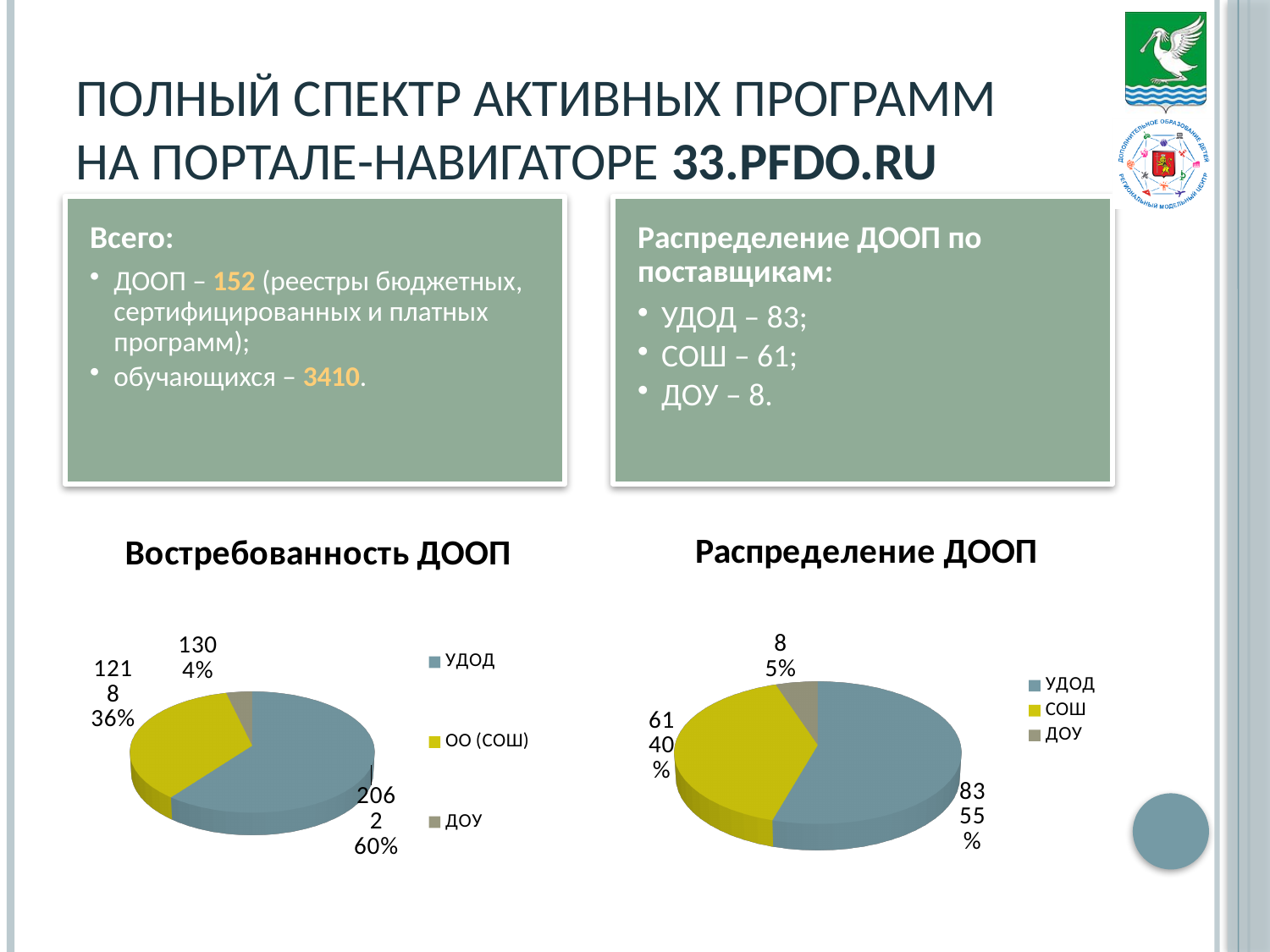
In the 'Востребованность ДООП' chart, which is larger, the slice for ОО (СОШ) or the slice for ДОУ? ОО (СОШ) In the 'Распределение ДООП' chart, which category has the smallest slice? ДОУ In the 'Востребованность ДООП' chart, what share of the pie does ДОУ have? 4% What kind of chart is the 'Распределение ДООП' chart? pie chart In the 'Распределение ДООП' chart, which category has the largest slice? УДОД In the 'Распределение ДООП' chart, what value is shown for ДОУ? 8 In the 'Распределение ДООП' chart, what value is shown for УДОД? 83 In the 'Востребованность ДООП' chart, what share of the pie does УДОД have? 60% In the 'Распределение ДООП' chart, what share of the pie does СОШ have? 40% How many entries does the legend of the 'Распределение ДООП' chart list? 3 In the 'Распределение ДООП' chart, what is the difference between the values for УДОД and СОШ? 22 How many slices does the 'Востребованность ДООП' pie chart have? 3